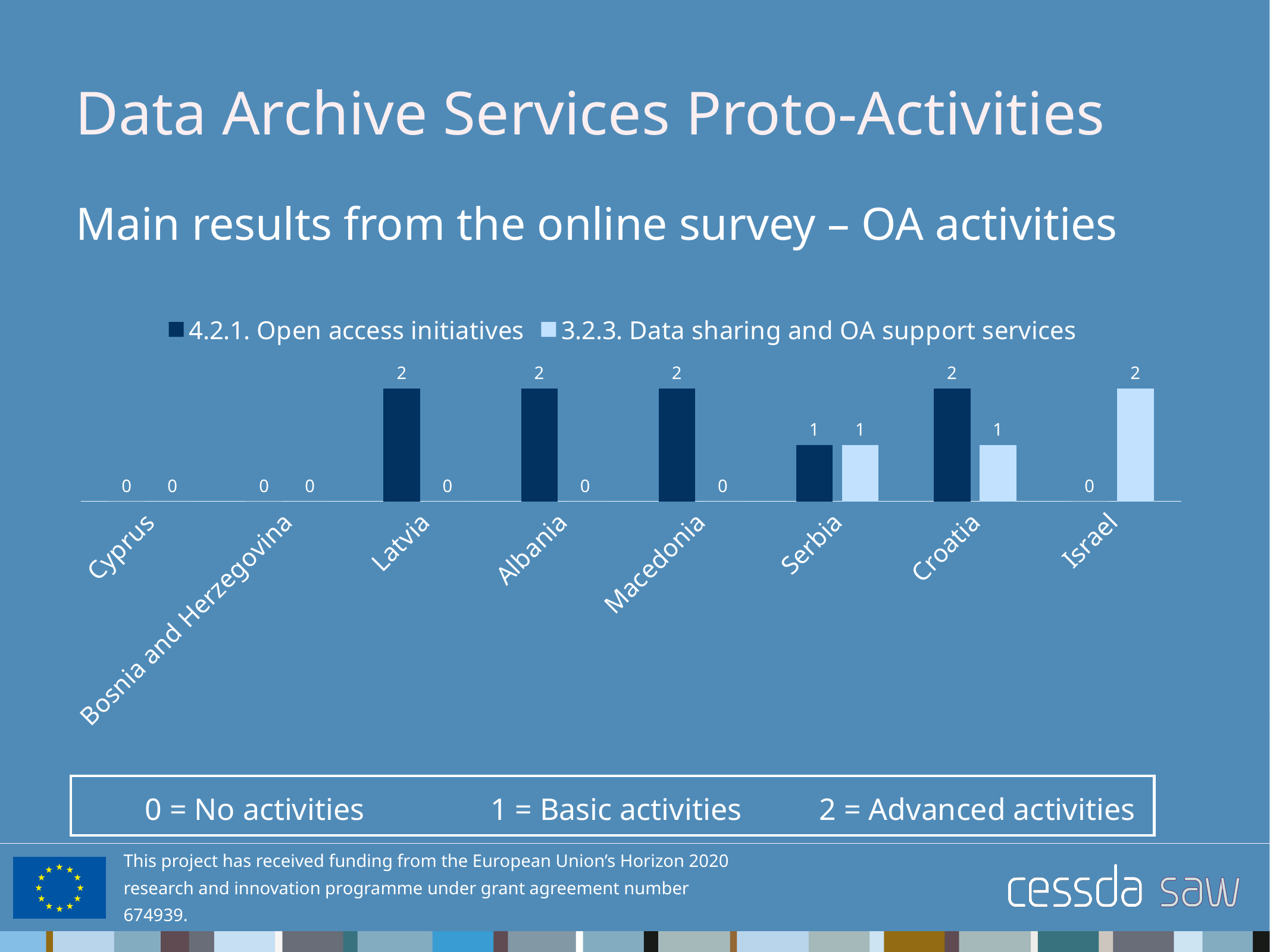
What kind of chart is shown on the slide? Bar chart What is the value for Croatia in the 3.2.3. Data sharing and OA support services series? 1 What is the value for Israel in the 3.2.3. Data sharing and OA support services series? 2 What is the value for Israel in the 4.2.1. Open access initiatives series? 0 How many series does the chart legend list? 2 What is the value for Serbia in the 4.2.1. Open access initiatives series? 1 For Israel, which series has the larger value: 4.2.1. Open access initiatives or 3.2.3. Data sharing and OA support services? 3.2.3. Data sharing and OA support services How many countries are shown on the x axis of the chart? 8 Which country is the only one with a value of 2 in the 3.2.3. Data sharing and OA support services series? Israel What is the difference between the 4.2.1. Open access initiatives value and the 3.2.3. Data sharing and OA support services value for Croatia? 1 What is the value for Latvia in the 4.2.1. Open access initiatives series? 2 According to the key on the slide, what does a value of 2 mean? Advanced activities